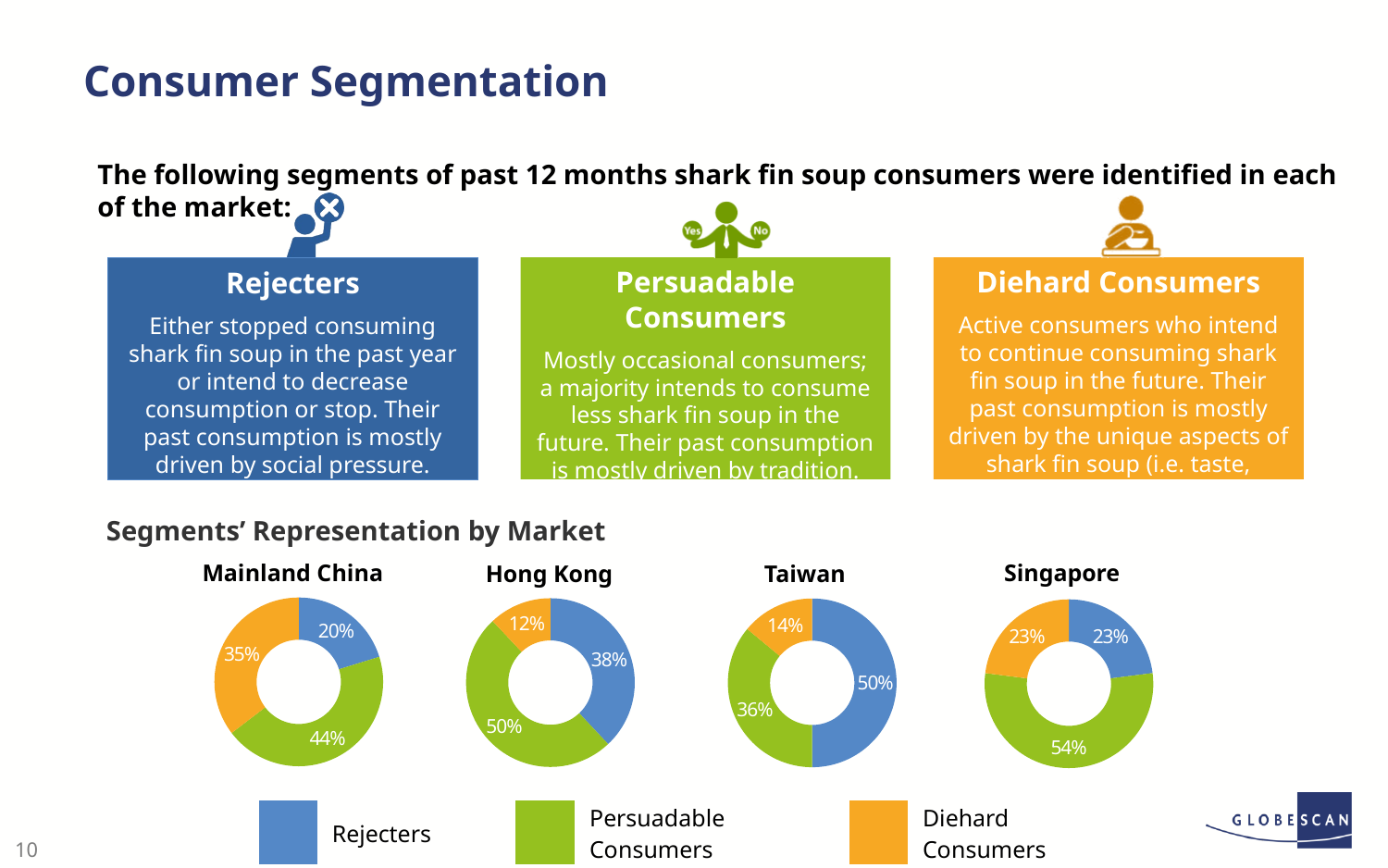
What kind of chart is used to show the segments' representation by market? Donut (pie) chart In the Mainland China chart, which segment has the largest share? Persuadable Consumers How many segments does the legend below the charts list? 3 In the Singapore chart, what share of consumers are Persuadable Consumers? 54% How many market charts are shown under 'Segments' Representation by Market'? 4 In the Hong Kong chart, what share of consumers are Diehard Consumers? 12% Is the Rejecters share larger in Hong Kong or in Singapore? Hong Kong In the Taiwan chart, which segment has the largest share? Rejecters In the Mainland China chart, what is the difference between the Persuadable Consumers share and the Rejecters share? 24% In the Mainland China chart, what share of consumers are Persuadable Consumers? 44% In the Hong Kong chart, which segment has the smallest share? Diehard Consumers In the Taiwan chart, what share of consumers are Rejecters? 50%